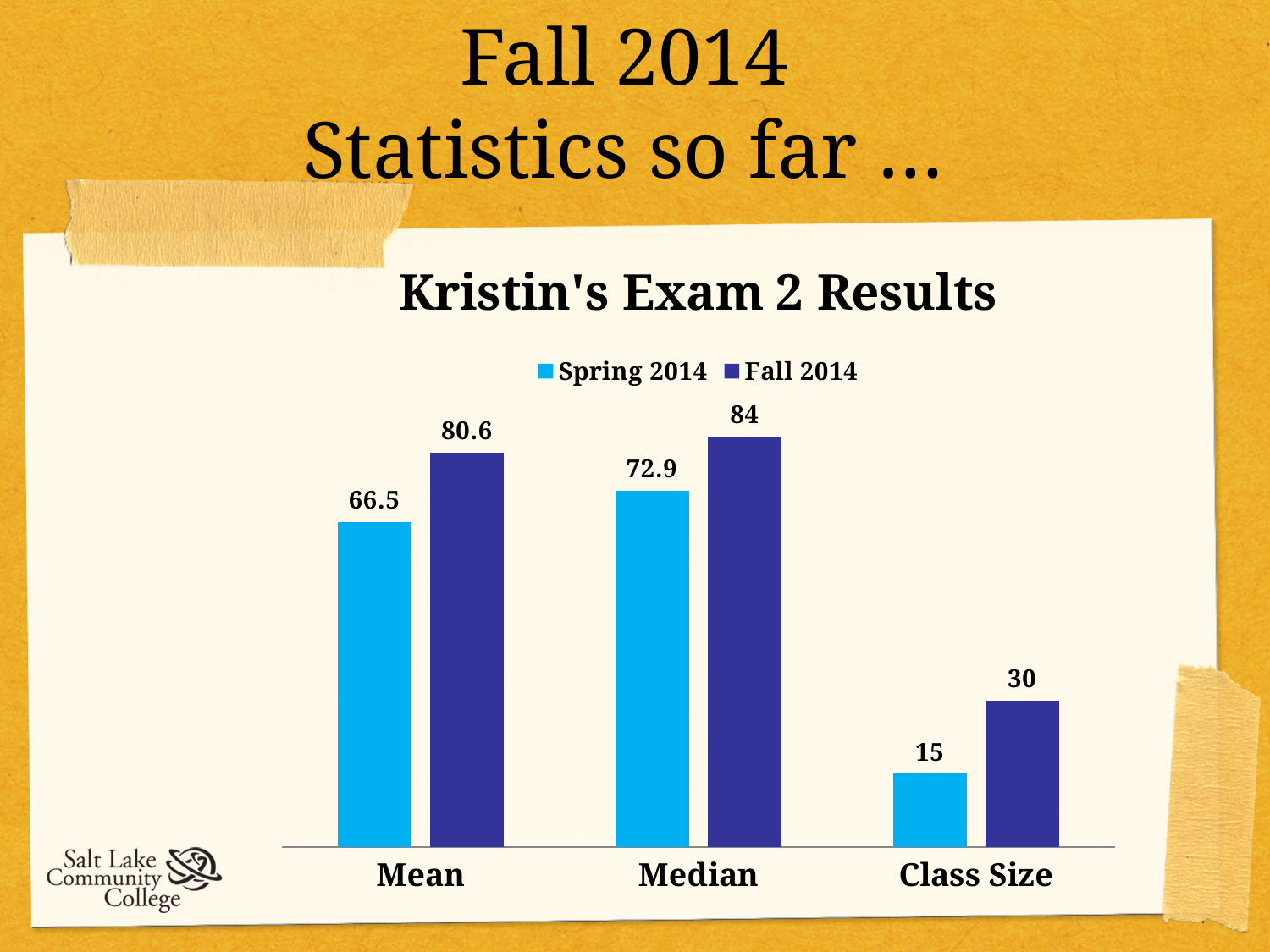
What is the Spring 2014 value for Mean? 66.5 What is the Fall 2014 value for Median? 84 Which category has the lowest Spring 2014 value? Class Size What is the Spring 2014 value for Median? 72.9 What is the Fall 2014 value for Class Size? 30 Which category has the highest Fall 2014 value? Median What is the difference between the Fall 2014 and Spring 2014 values for Mean? 14.1 How many series does the legend list? 2 Which is larger for Median: Spring 2014 or Fall 2014? Fall 2014 How many categories are shown on the x axis? 3 What is the difference between the Fall 2014 and Spring 2014 values for Class Size? 15 What kind of chart is shown? Bar chart